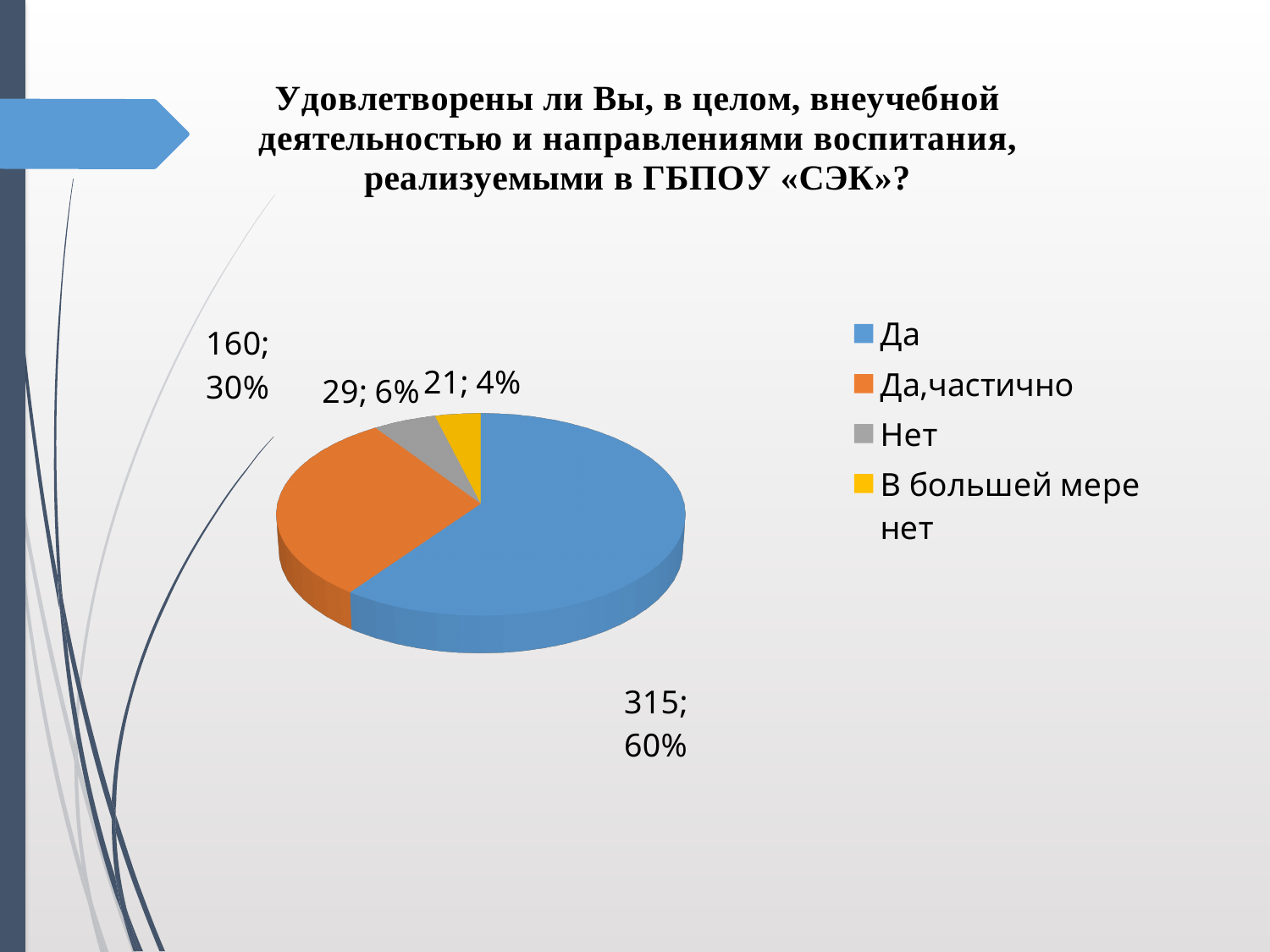
What share of the pie does "Да,частично" represent? 30% What is the value for "Нет"? 29 What is the value for "Да,частично"? 160 What kind of chart is shown on the slide? pie chart What share of the pie does "Да" represent? 60% Which category has the smallest slice? В большей мере нет Which colour represents "Нет" in the legend? grey What is the value for "В большей мере нет"? 21 What is the difference between the values for "Да" and "Да,частично"? 155 What is the value for "Да"? 315 How many categories does the pie chart have? 4 Which category has the largest slice? Да